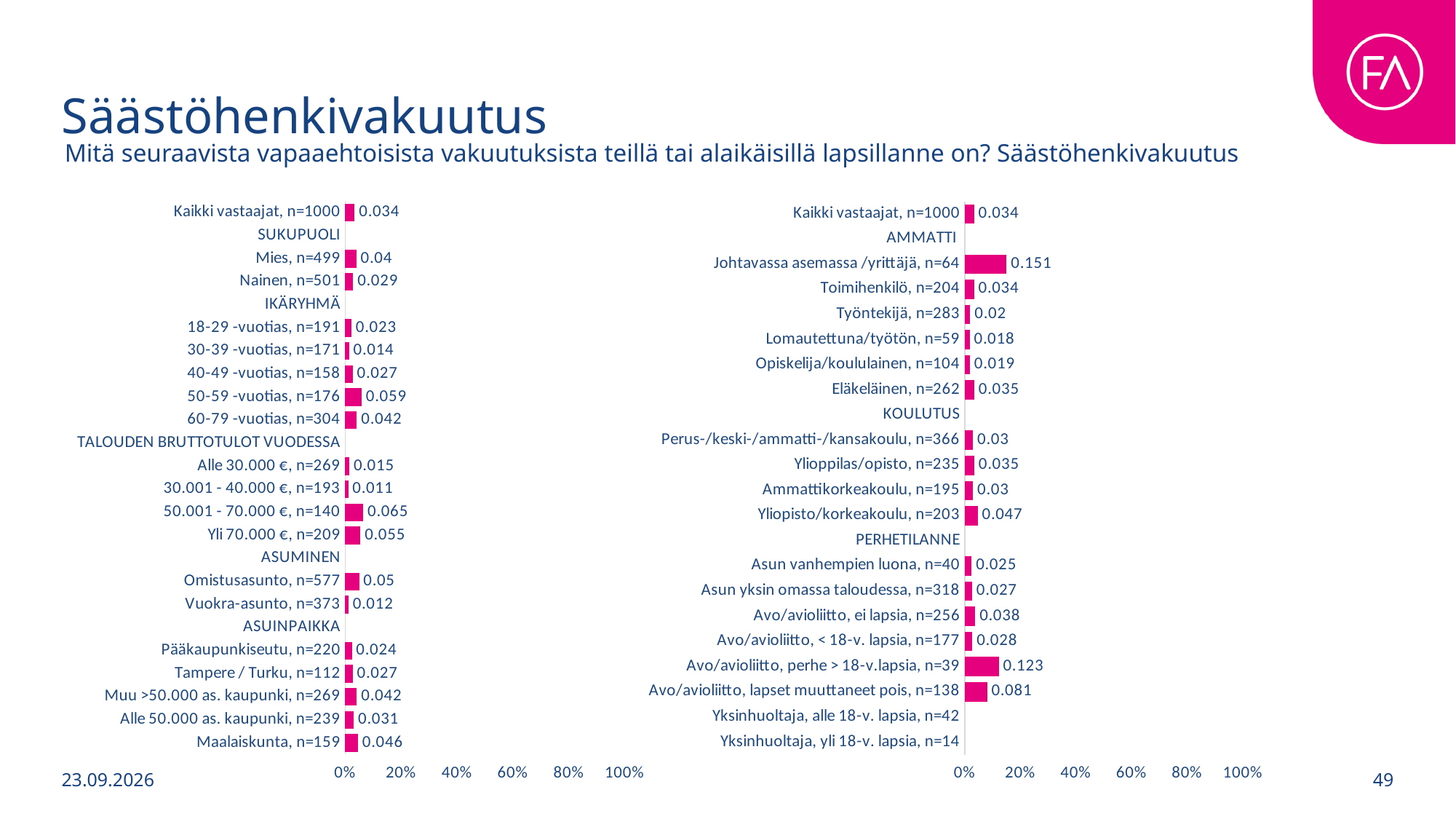
In the left chart, what is the value for Mies, n=499? 0.04 In the left chart, what is the difference between the values for 50.001 - 70.000 € and Yli 70.000 €? 0.01 In the left chart, which category has the highest value? 50.001 - 70.000 €, n=140 What type of chart is shown on the left of the slide? Bar chart In the left chart, which category has the lowest value? 30.001 - 40.000 €, n=193 In the right chart, what is the difference between the values for Johtavassa asemassa /yrittäjä and Avo/avioliitto, perhe > 18-v.lapsia? 0.028 In the left chart, what is the value for 50-59 -vuotiaat, n=176? 0.059 In the right chart, what is the value for Yliopisto/korkeakoulu, n=203? 0.047 In the right chart, which category has the highest value? Johtavassa asemassa /yrittäjä, n=64 In the right chart, which is larger: the value for Työntekijä or Eläkeläinen? Eläkeläinen In the right chart, what is the value for Johtavassa asemassa /yrittäjä, n=64? 0.151 In the left chart, which is larger: the value for Omistusasunto or Vuokra-asunto? Omistusasunto